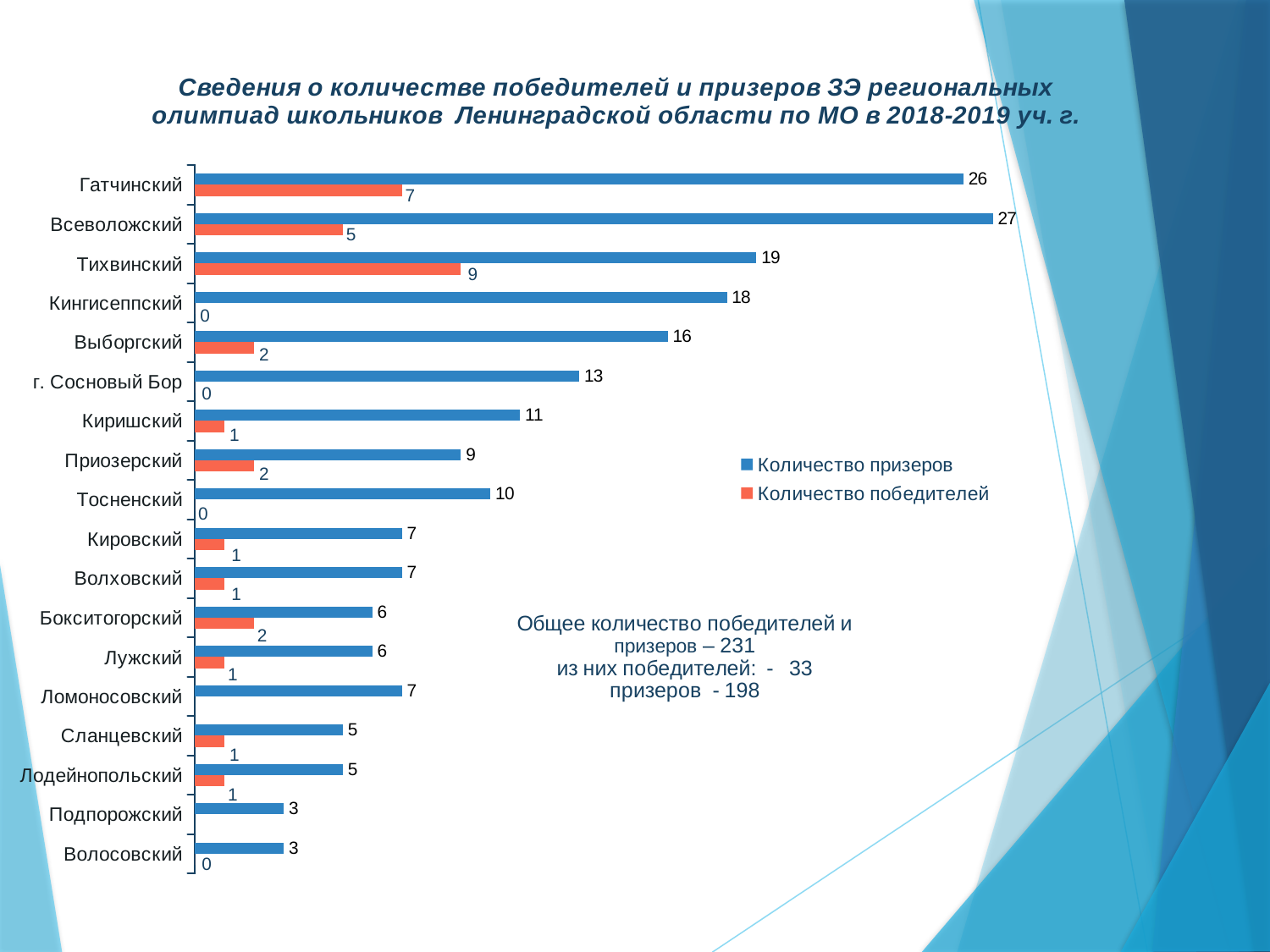
Which district has the highest value for Количество победителей? Тихвинский Which district has the highest value for Количество призеров? Всеволожский Which is larger: Количество призеров for Кингисеппский or for Выборгский? Кингисеппский What is the value of Количество призеров for г. Сосновый Бор? 13 How many series does the legend list? 2 What is the difference between Количество призеров and Количество победителей for Гатчинский? 19 What kind of chart is shown on the slide? bar chart What is the value of Количество победителей for Кингисеппский? 0 How many districts (categories) are shown on the chart? 18 What is the value of Количество призеров for Всеволожский? 27 Which series is shown in orange according to the legend? Количество победителей What is the value of Количество победителей for Тихвинский? 9